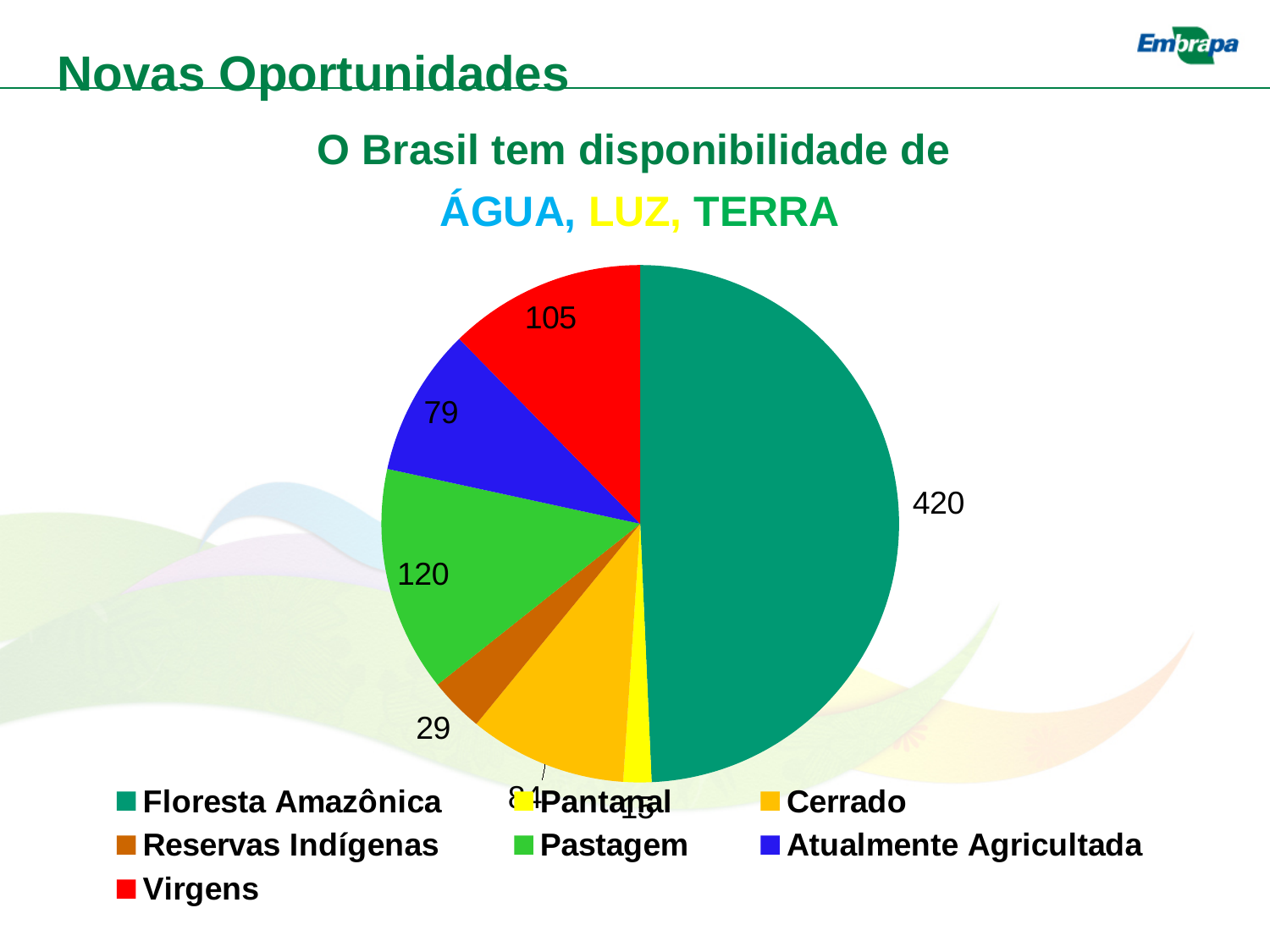
What type of chart is shown on the slide? pie chart What is the value shown for Pastagem? 120 Which category has the smallest slice of the pie? Pantanal Which is larger, the value for Pastagem or the value for Virgens? Pastagem Which category has the largest slice of the pie? Floresta Amazônica What is the value shown for Floresta Amazônica? 420 What is the value shown for Atualmente Agricultada? 79 What is the value shown for Virgens? 105 What is the value shown for Reservas Indígenas? 29 How many categories does the legend of the pie chart list? 7 What is the difference between the values for Atualmente Agricultada and Reservas Indígenas? 50 What is the difference between the values for Floresta Amazônica and Pastagem? 300